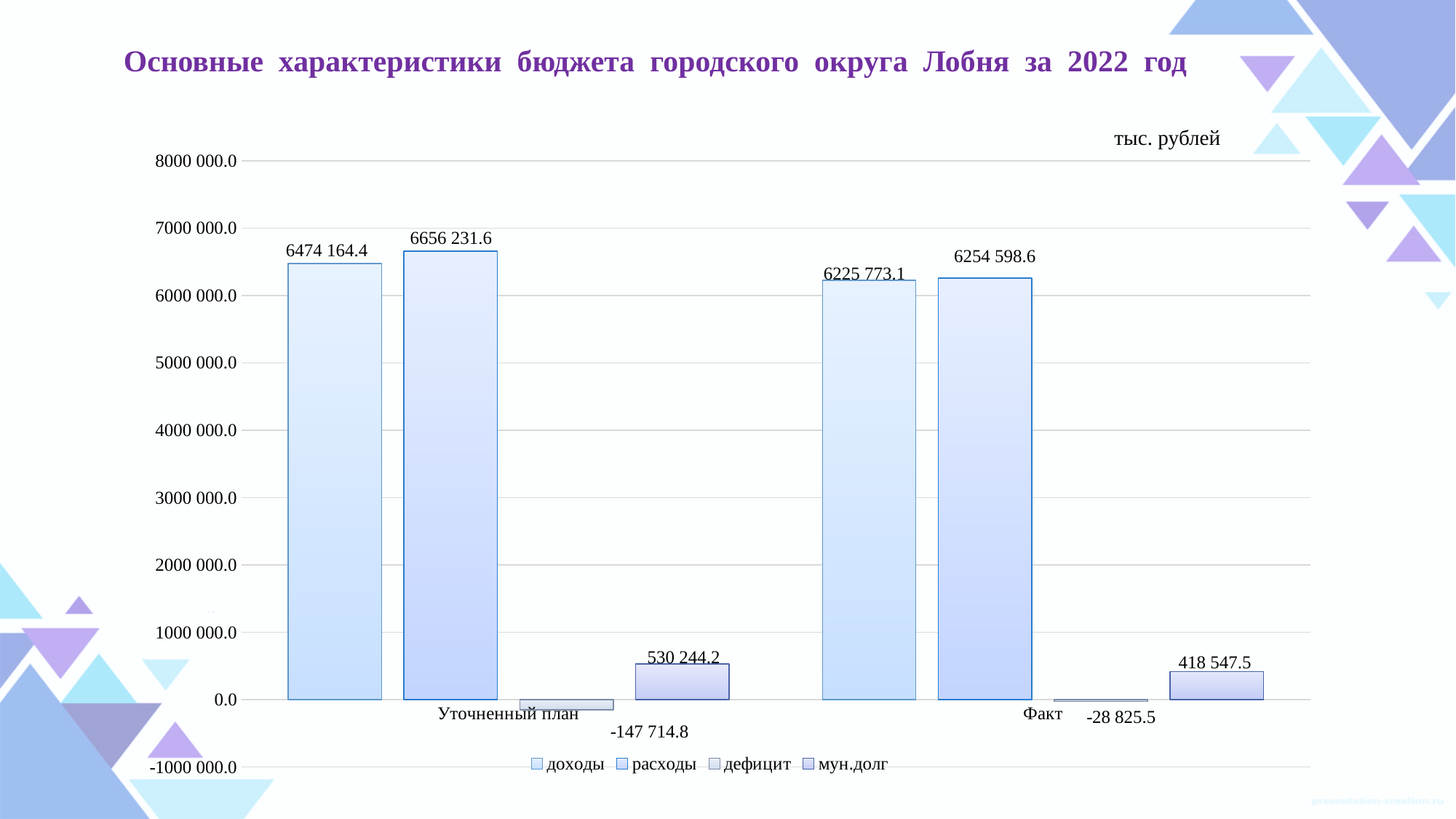
Which is larger: доходы for Уточненный план or доходы for Факт? доходы for Уточненный план What is the value of мун.долг for Факт? 418 547.5 What is the difference between мун.долг for Уточненный план and мун.долг for Факт? 111 696.7 What is the value of расходы for Факт? 6254 598.6 What is the value of доходы for Уточненный план? 6474 164.4 What is the difference between расходы and доходы for Уточненный план? 182 067.2 What unit is indicated above the chart? тыс. рублей How many series does the legend list? 4 Which series has the lowest value in the Факт group? дефицит What is the value of дефицит for Уточненный план? -147 714.8 Which series has the highest value in the Уточненный план group? расходы What kind of chart is shown on the slide? bar chart